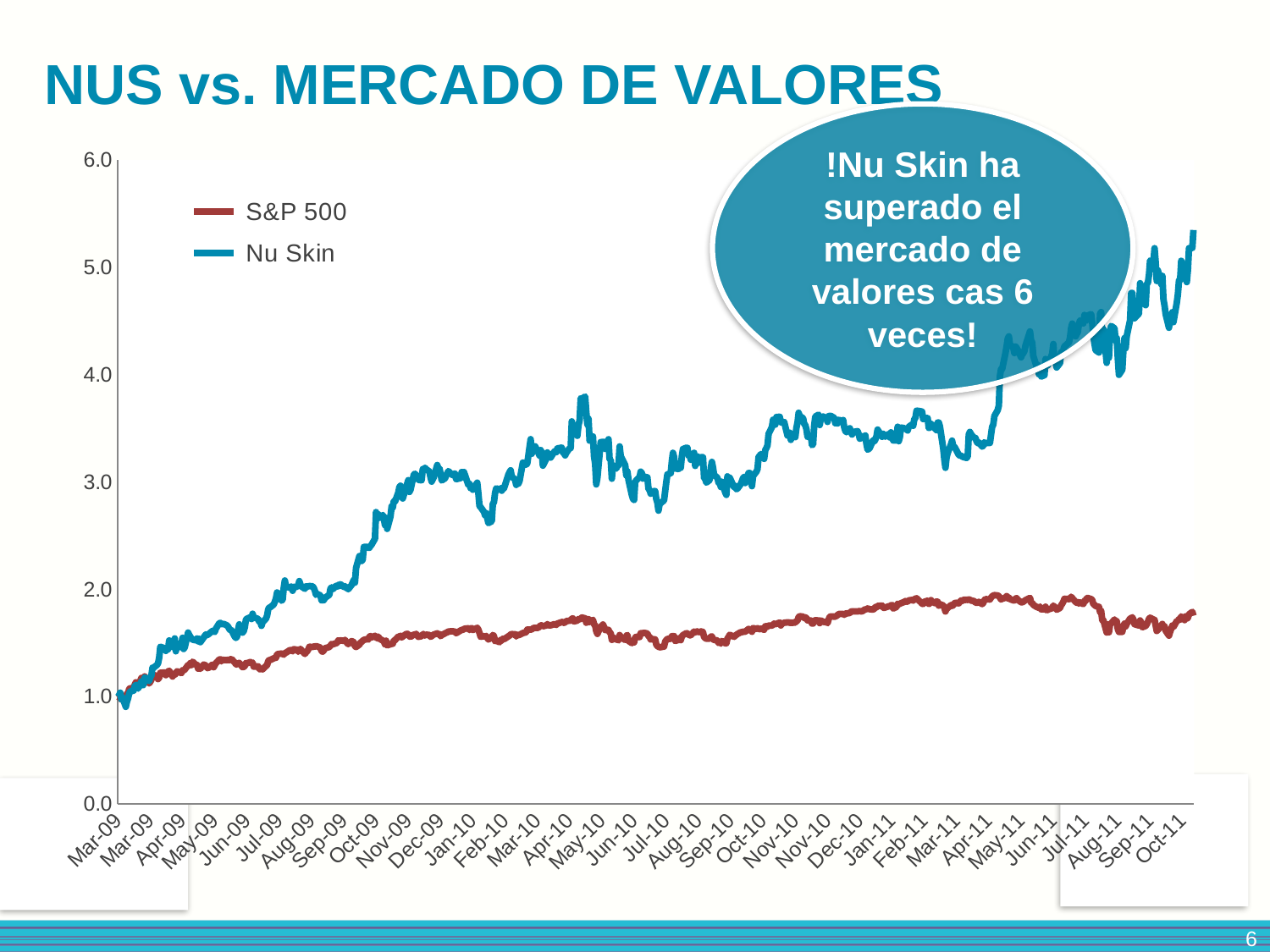
How many series does the legend list? 2 Is the value for Nu Skin at Apr-11 greater or less than 3.0? greater What is the title of the slide containing the chart? NUS vs. MERCADO DE VALORES Which series reaches the highest value on the chart? Nu Skin What kind of chart is shown on the slide? line chart Is the value for Nu Skin at Oct-09 greater or less than 2.0? greater Which two series are listed in the chart legend? S&P 500 and Nu Skin Is the value for S&P 500 at Jan-11 greater or less than 3.0? less Does the Nu Skin line generally rise or fall from Mar-09 to Oct-11? rise At Oct-11, which series has the larger value, Nu Skin or S&P 500? Nu Skin